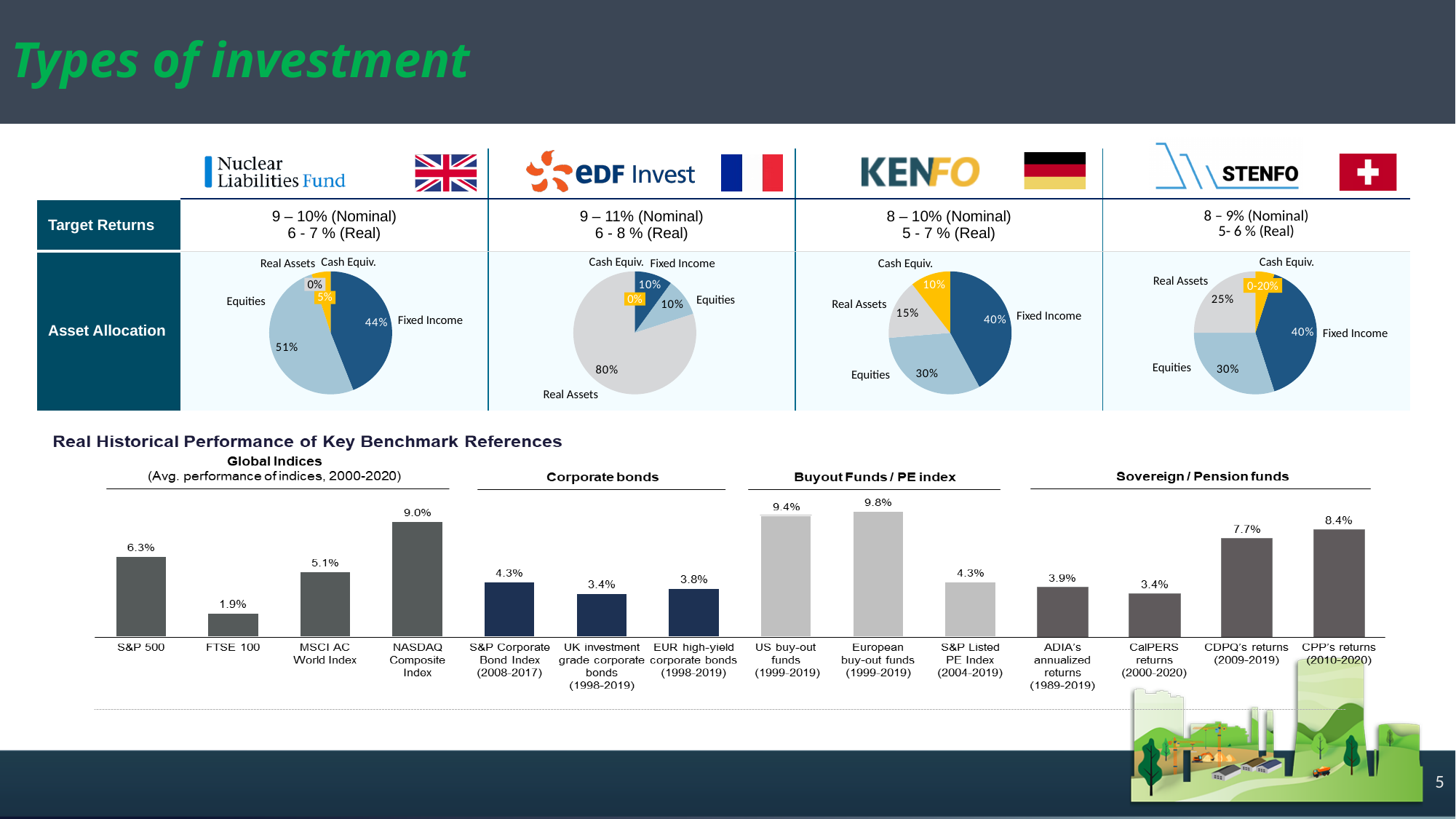
In the Real Historical Performance bar chart, how many categories are shown in the Corporate bonds group? 3 In the KENFO asset allocation pie chart, which category has the largest share? Fixed Income In the Real Historical Performance bar chart, what is the value for NASDAQ Composite Index? 9.0% In the STENFO asset allocation pie chart, what share is Real Assets? 25% What type of chart is used for the Real Historical Performance of Key Benchmark References? Bar chart In the Real Historical Performance bar chart, what is the difference between CPP's returns and CDPQ's returns? 0.7% In the Real Historical Performance bar chart, which category has the highest value overall? European buy-out funds (1999-2019) In the EDF Invest asset allocation pie chart, what share is Real Assets? 80% In the Nuclear Liabilities Fund asset allocation pie chart, what share is Equities? 51% In the KENFO asset allocation pie chart, what is the difference between the Fixed Income and Real Assets shares? 25% In the Real Historical Performance bar chart, which is larger: S&P 500 or MSCI AC World Index? S&P 500 In the Real Historical Performance bar chart, which category in the Global Indices group has the lowest value? FTSE 100